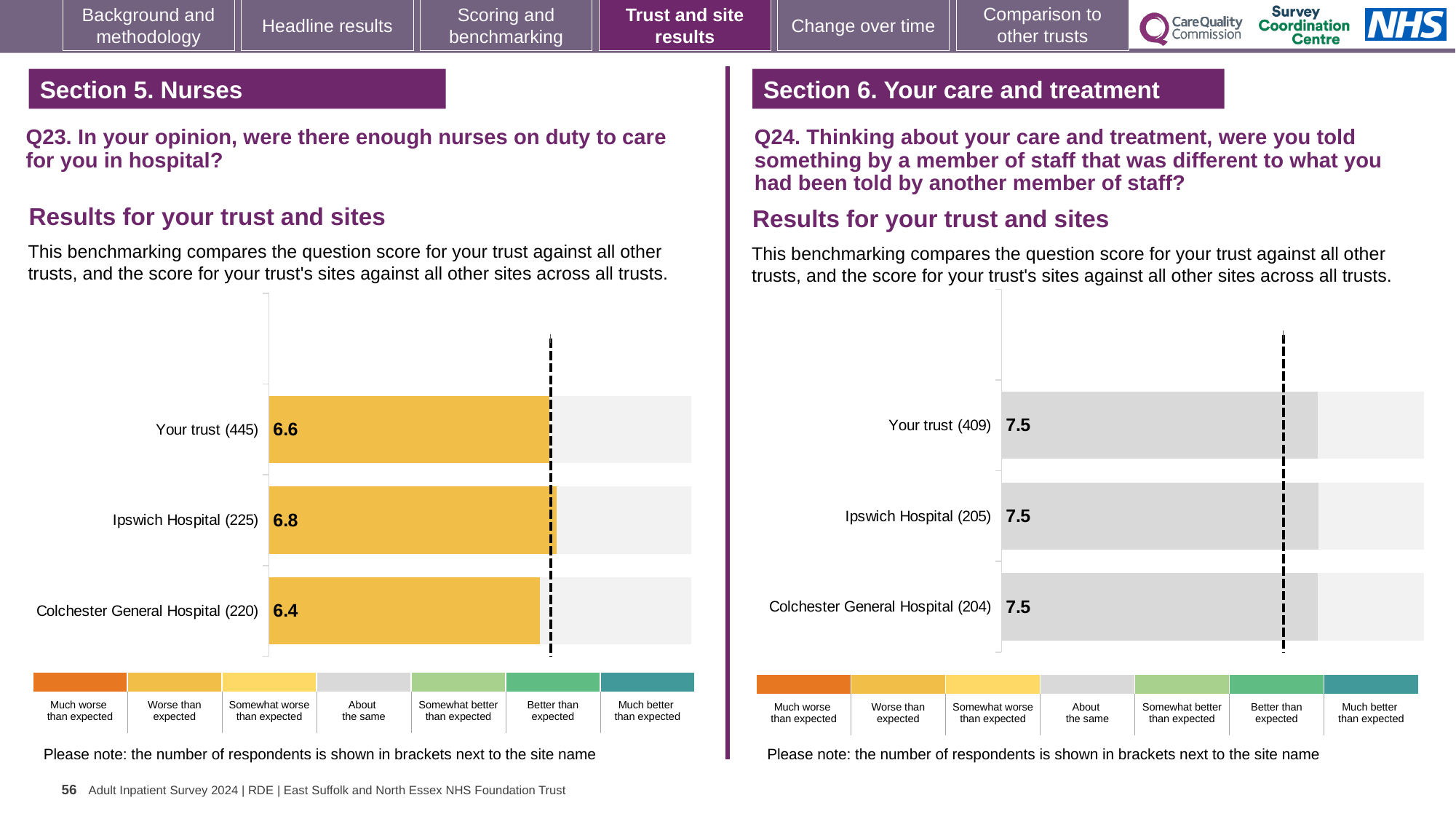
In the Q23 chart on the left, which site has the lowest score? Colchester General Hospital How many bars are shown in the Q24 chart on the right? 3 What kind of chart is used for the Q23 results on the left? Bar chart In the Q23 chart on the left, which has the larger score, Your trust or Colchester General Hospital? Your trust In the Q23 chart on the left, which site has the highest score? Ipswich Hospital In the Q23 chart on the left, what is the score for Colchester General Hospital? 6.4 In the Q23 chart on the left, what is the score for Ipswich Hospital? 6.8 In the Q24 chart on the right, what is the score for Colchester General Hospital? 7.5 In the Q23 chart on the left, what is the score for Your trust? 6.6 In the Q23 chart on the left, how many respondents are shown in brackets for Ipswich Hospital? 225 In the Q23 chart on the left, what is the difference between the Ipswich Hospital score and the Colchester General Hospital score? 0.4 In the Q24 chart on the right, what is the score for Your trust? 7.5